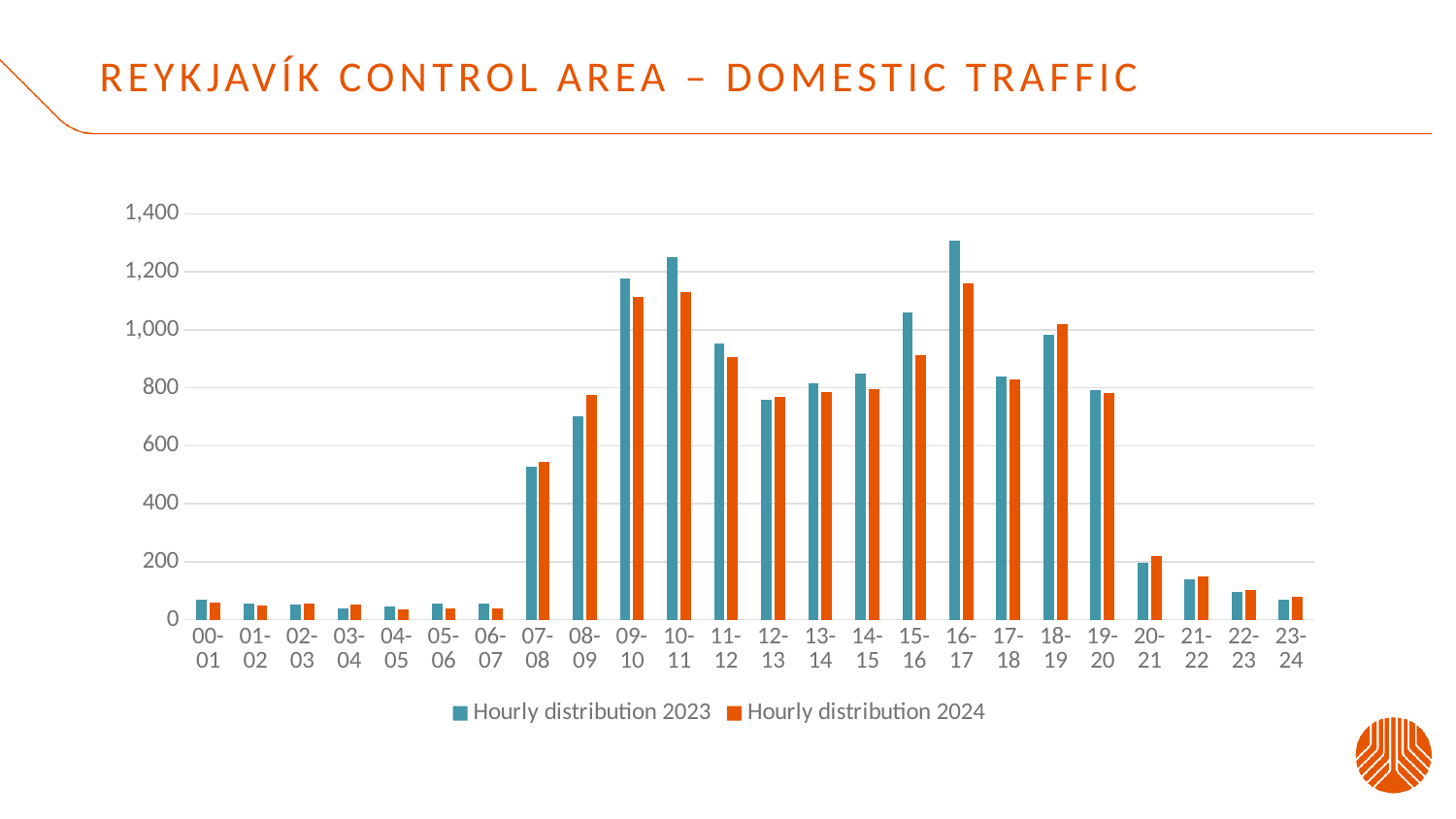
Is the value for Hourly distribution 2023 at 16-17 greater or less than 1,200? greater What kind of chart is shown on the slide? bar chart How many series does the legend list? 2 Is the value for Hourly distribution 2024 at 15-16 greater or less than 1,000? less How many hourly categories are shown on the x axis? 24 At 08-09, which series has the larger value, Hourly distribution 2023 or Hourly distribution 2024? Hourly distribution 2024 Which hour has the highest value for Hourly distribution 2023? 16-17 At 16-17, which series has the larger value, Hourly distribution 2023 or Hourly distribution 2024? Hourly distribution 2023 Do the values for Hourly distribution 2023 rise or fall from 07-08 to 10-11? rise Is the value for Hourly distribution 2023 at 07-08 greater or less than 600? less Which hour has the highest value for Hourly distribution 2024? 16-17